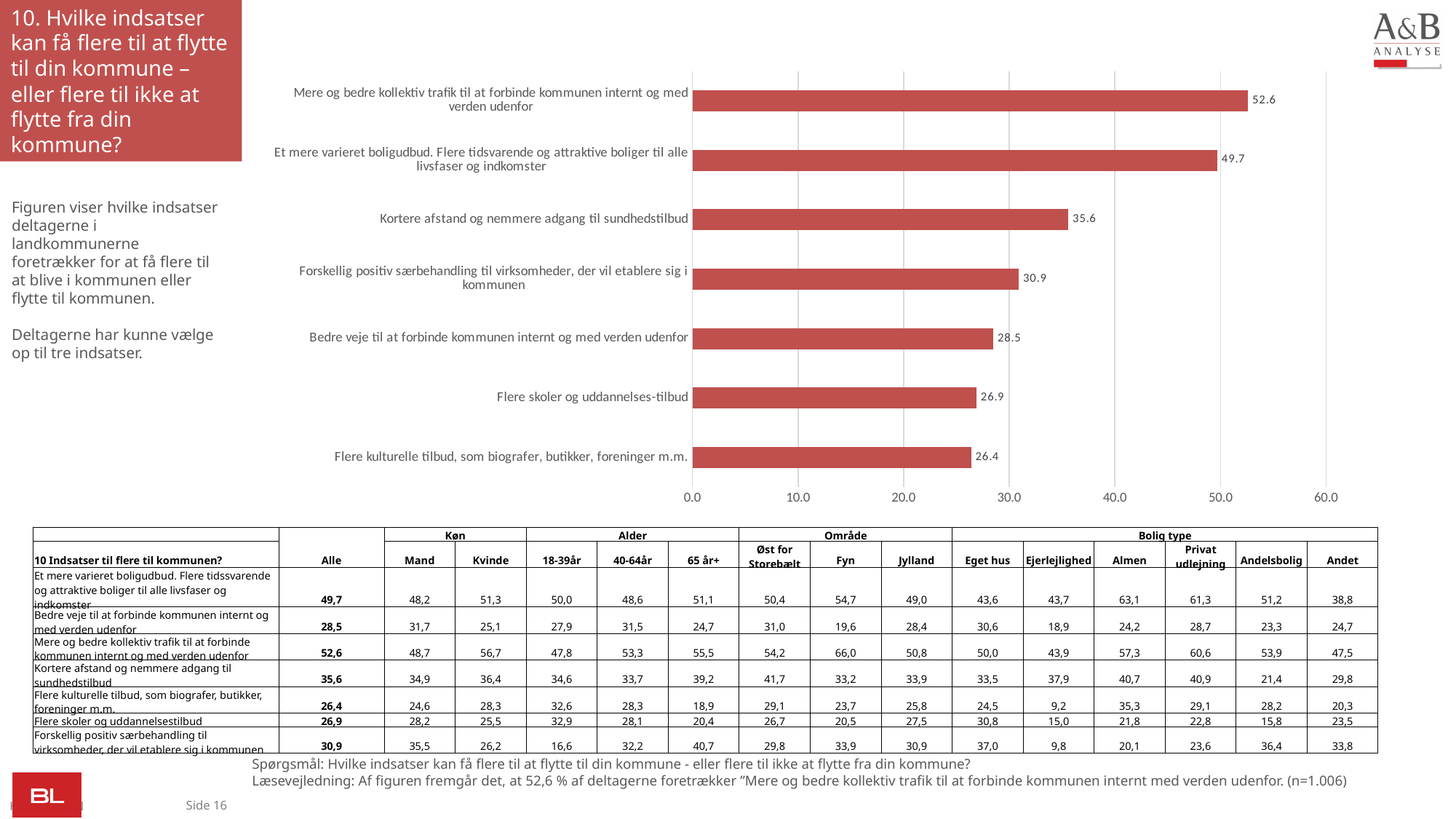
Is the value for "Et mere varieret boligudbud. Flere tidsvarende og attraktive boliger til alle livsfaser og indkomster" greater or less than 40.0? greater What value is shown for "Kortere afstand og nemmere adgang til sundhedstilbud"? 35.6 What type of chart is shown on the slide? Bar chart How many categories are shown in the bar chart? 7 Which category has the highest value in the chart? Mere og bedre kollektiv trafik til at forbinde kommunen internt og med verden udenfor What is the difference between the values for "Flere skoler og uddannelses-tilbud" and "Flere kulturelle tilbud, som biografer, butikker, foreninger m.m."? 0.5 What is the difference between the values for "Mere og bedre kollektiv trafik til at forbinde kommunen internt og med verden udenfor" and "Et mere varieret boligudbud. Flere tidsvarende og attraktive boliger til alle livsfaser og indkomster"? 2.9 Which category has the lowest value in the chart? Flere kulturelle tilbud, som biografer, butikker, foreninger m.m. What value is shown for "Flere skoler og uddannelses-tilbud"? 26.9 Which has a larger value: "Kortere afstand og nemmere adgang til sundhedstilbud" or "Forskellig positiv særbehandling til virksomheder, der vil etablere sig i kommunen"? Kortere afstand og nemmere adgang til sundhedstilbud What value is shown for "Bedre veje til at forbinde kommunen internt og med verden udenfor"? 28.5 What is the maximum value shown on the chart's horizontal axis? 60.0